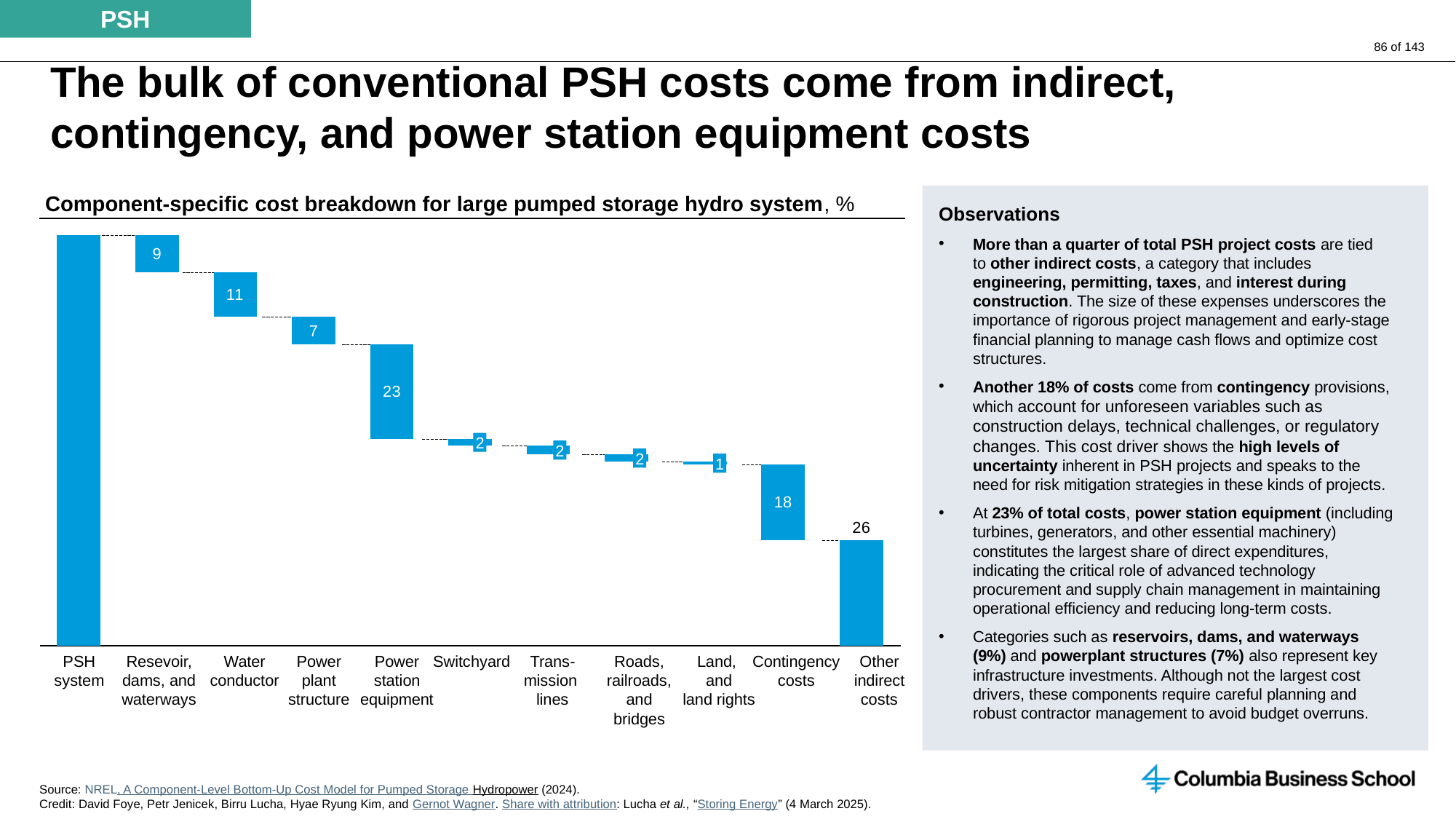
What is the title of the chart? Component-specific cost breakdown for large pumped storage hydro system, % What is the value for Contingency costs? 18 What is the value for Power station equipment? 23 Which component has the lowest value? Land, and land rights What is the value for Other indirect costs? 26 Which labelled component has the highest value? Other indirect costs Which is larger, the value for Water conductor or the value for Resevoir, dams, and waterways? Water conductor What is the value for Water conductor? 11 How many categories are shown on the x axis? 11 What is the difference between the values for Other indirect costs and Power station equipment? 3 What is the value for Land, and land rights? 1 What kind of chart is shown on the slide? Waterfall bar chart